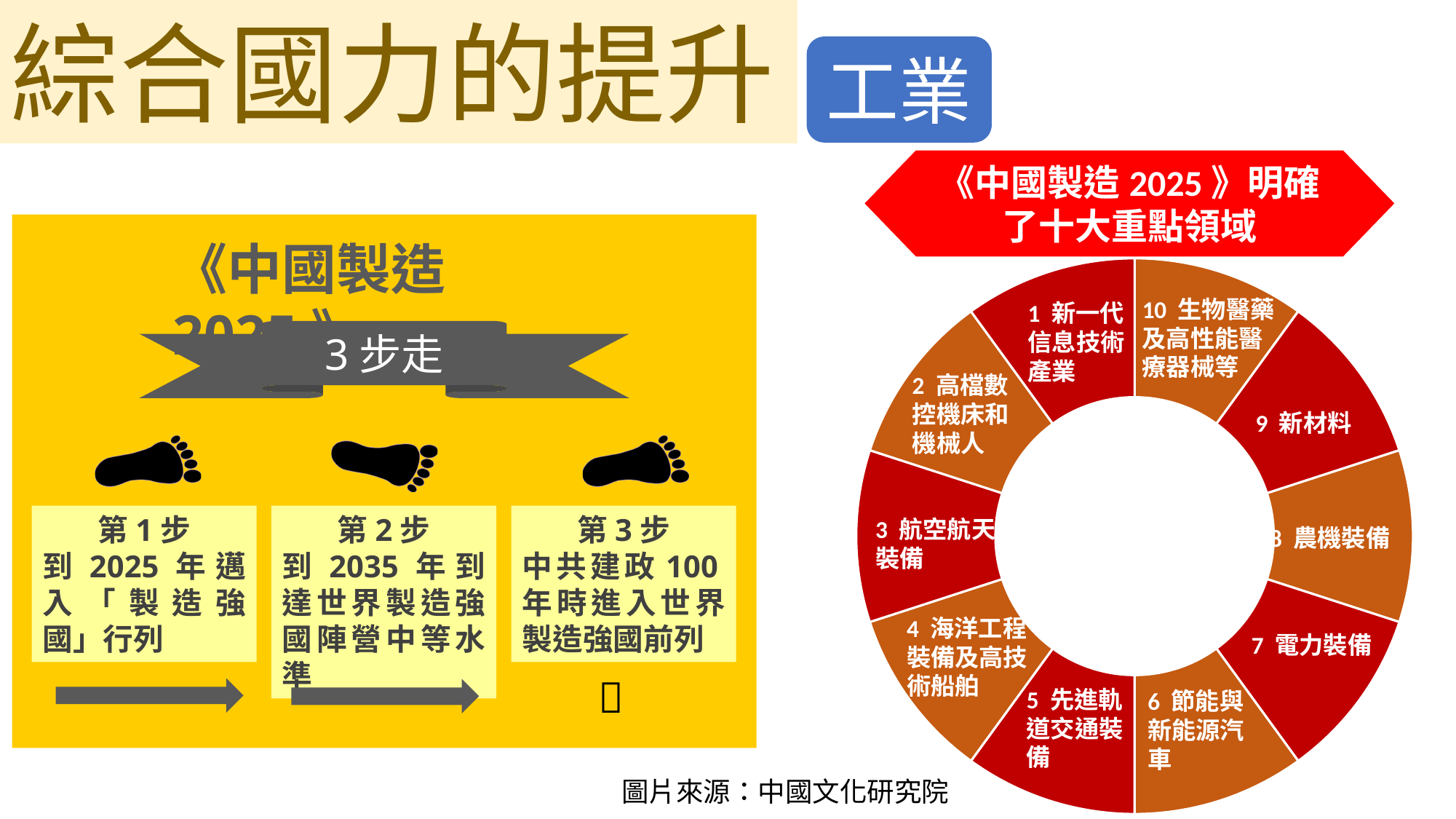
In the ring chart, which area is labelled number 10? 生物醫藥及高性能醫療器械等 What kind of chart is shown on the right side of the slide? Doughnut (ring) chart What two colours alternate between the segments of the ring chart? Dark red and orange-brown In the ring chart, which area is labelled number 1? 新一代信息技術產業 In the ring chart, which area is labelled number 7? 電力裝備 In the ring chart, which area is labelled number 9? 新材料 In the ring chart, what number is given to 節能與新能源汽車? 6 In the ring chart, what number is given to 航空航天裝備? 3 What is the title shown above the ring chart on the right? 《中國製造 2025 》明確了十大重點領域 How many segments does the ring chart on the right of the slide have? 10